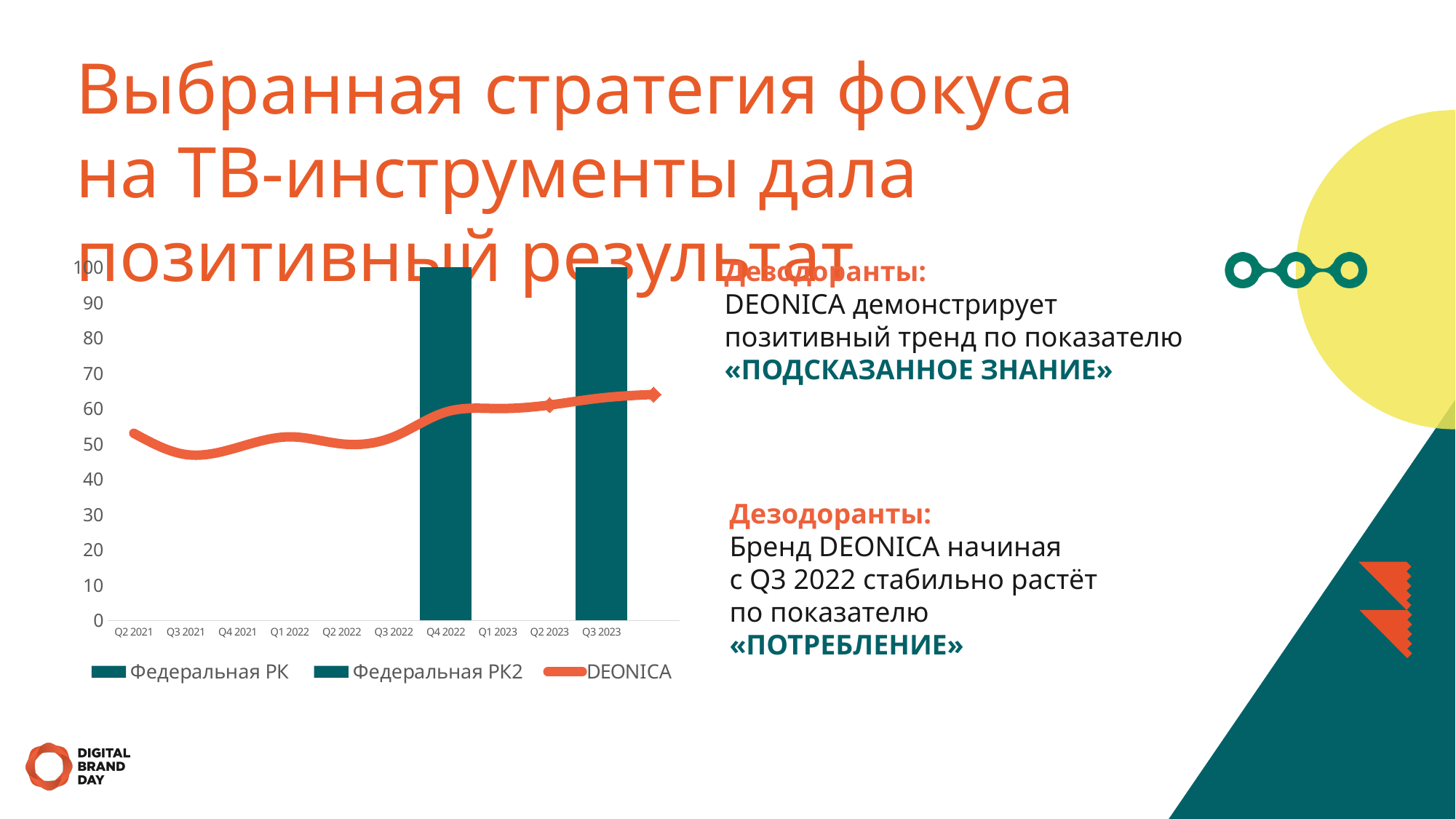
What value does the bar at Q4 2022 reach on the y axis? 100 How many quarters are shown on the x axis of the chart? 10 Is the DEONICA value for Q3 2023 greater or less than 60? greater In which quarter does the DEONICA line reach its lowest point? Q3 2021 In which quarters do bars appear in the chart? Q4 2022 and Q3 2023 Does the DEONICA line rise or fall from Q3 2022 to Q3 2023? rise What value does the bar at Q3 2023 reach on the y axis? 100 Which series in the chart is drawn as a line rather than bars? DEONICA Is the DEONICA value for Q2 2021 greater or less than 50? greater Is the DEONICA value for Q3 2021 greater or less than 50? less How many series does the chart legend list? 3